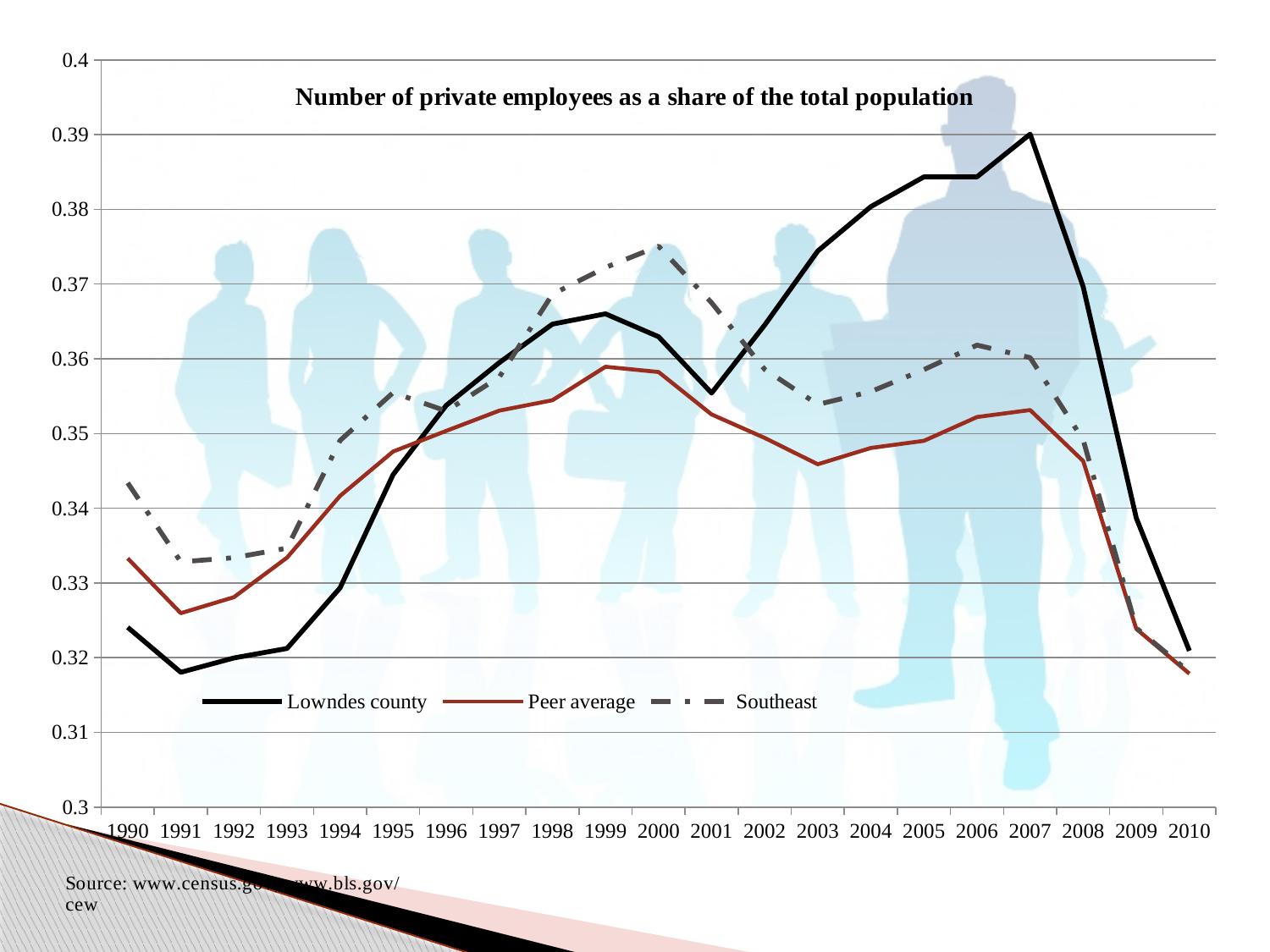
Is the value for Southeast in 2000 greater or less than 0.37? greater In 2000, which is larger: Lowndes county or Southeast? Southeast How many years are plotted along the x axis? 21 Does the Lowndes county series rise or fall from 2007 to 2010? fall Is the value for Peer average in 1991 greater or less than 0.33? less What kind of chart is shown on the slide? line chart How many series does the legend list? 3 What is the title of the chart? Number of private employees as a share of the total population In which year does the Lowndes county series reach its highest value? 2007 In which year does the Southeast series reach its highest value? 2000 Is the value for Lowndes county in 2007 greater or less than 0.38? greater In which year does the Lowndes county series reach its lowest value? 1991